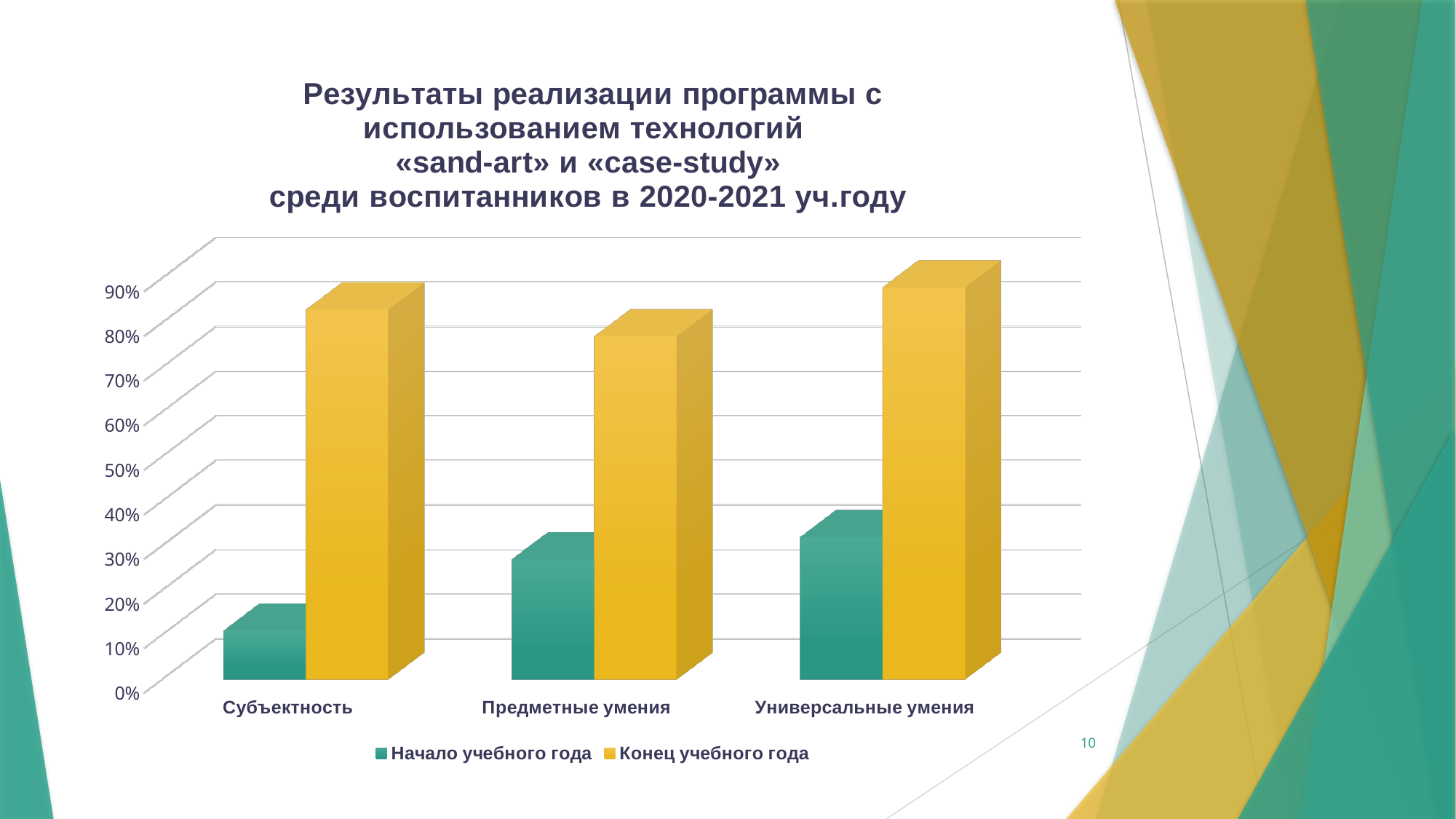
How many categories are shown on the x axis of the chart? 3 What kind of chart is shown on the slide? bar chart Which category has the highest value for Конец учебного года? Универсальные умения For Субъектность, which is larger: the value for Начало учебного года or for Конец учебного года? Конец учебного года Is the value for Начало учебного года in Субъектность greater or less than 20%? less Which colour represents the series Конец учебного года in the chart? yellow Do the values for Начало учебного года rise or fall from Субъектность to Универсальные умения? rise Is the value for Конец учебного года in Универсальные умения greater or less than 80%? greater How many series does the chart legend list? 2 Is the value for Начало учебного года in Предметные умения greater or less than 40%? less Which category has the lowest value for Начало учебного года? Субъектность